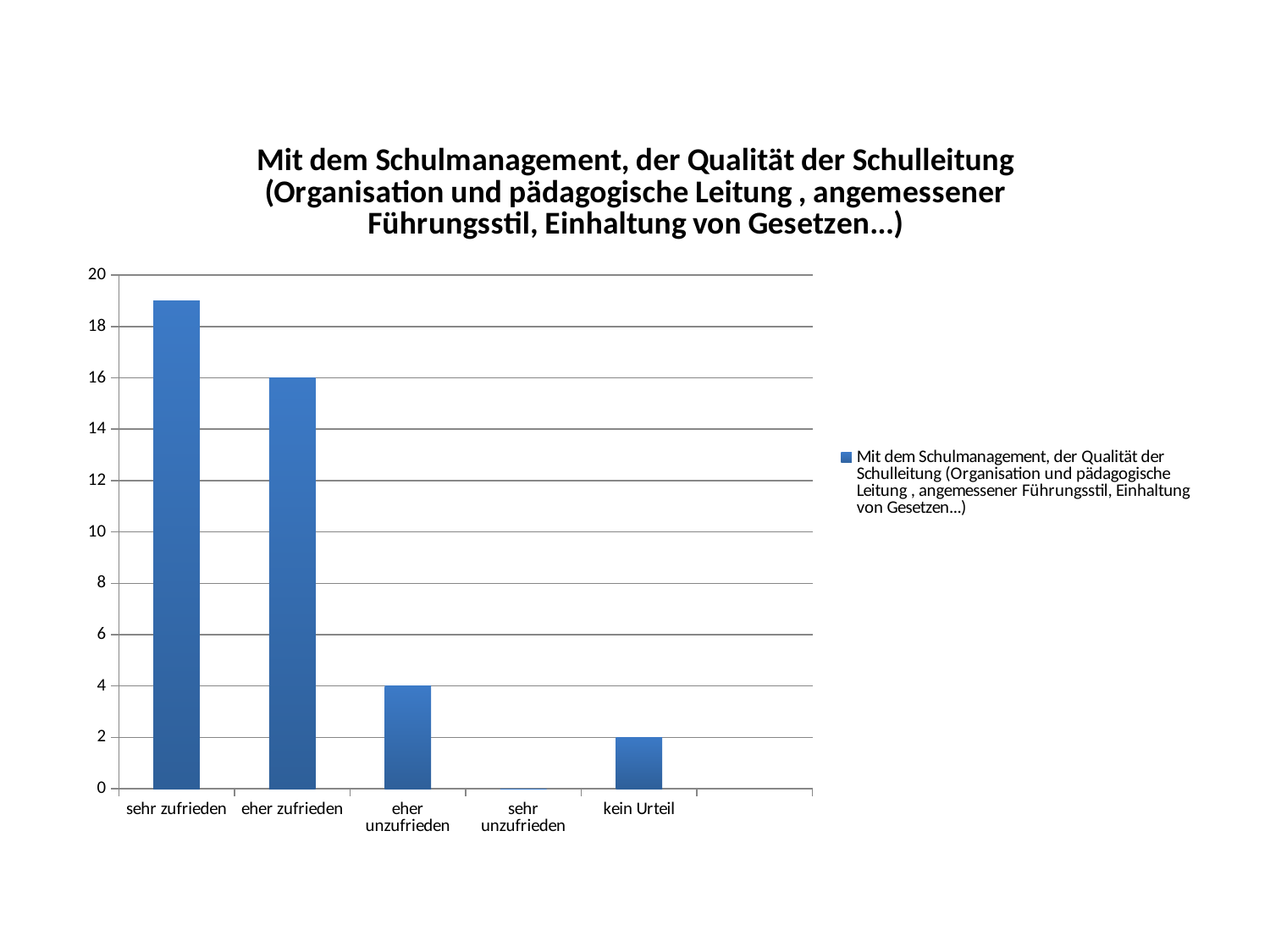
Is the value for sehr zufrieden greater or less than 18? greater What is the highest value shown on the vertical axis? 20 What is the difference between the values for eher zufrieden and eher unzufrieden? 12 How many series does the legend list? 1 What is the value for eher unzufrieden? 4 Which category has the lowest value? sehr unzufrieden Which category has the highest value? sehr zufrieden How many categories are shown on the x axis? 5 What is the value for kein Urteil? 2 Which is larger, the value for eher unzufrieden or the value for kein Urteil? eher unzufrieden What kind of chart is shown on the slide? bar chart What is the value for eher zufrieden? 16